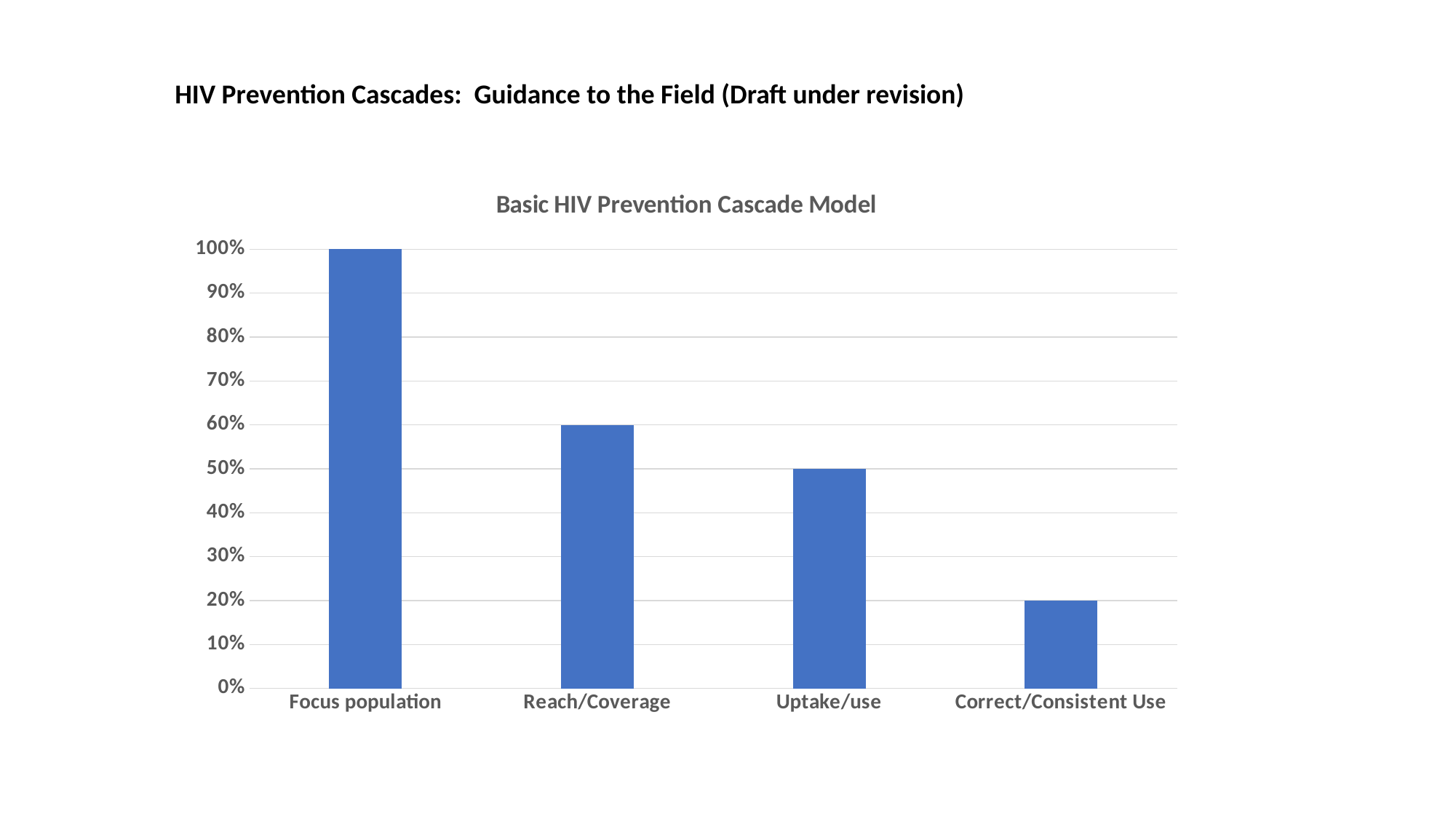
Which category has the highest value? Focus population What is the value for Correct/Consistent Use? 20% Which category has the lowest value? Correct/Consistent Use What kind of chart is shown on the slide? bar chart What is the difference between the values for Reach/Coverage and Correct/Consistent Use? 40% How many categories are shown on the x axis? 4 What is the value for Uptake/use? 50% Which is larger, the value for Reach/Coverage or the value for Uptake/use? Reach/Coverage What is the value for Focus population? 100% What is the value for Reach/Coverage? 60% Is the value for Uptake/use greater or less than 70%? less Do the values rise or fall from left to right along the x axis? fall